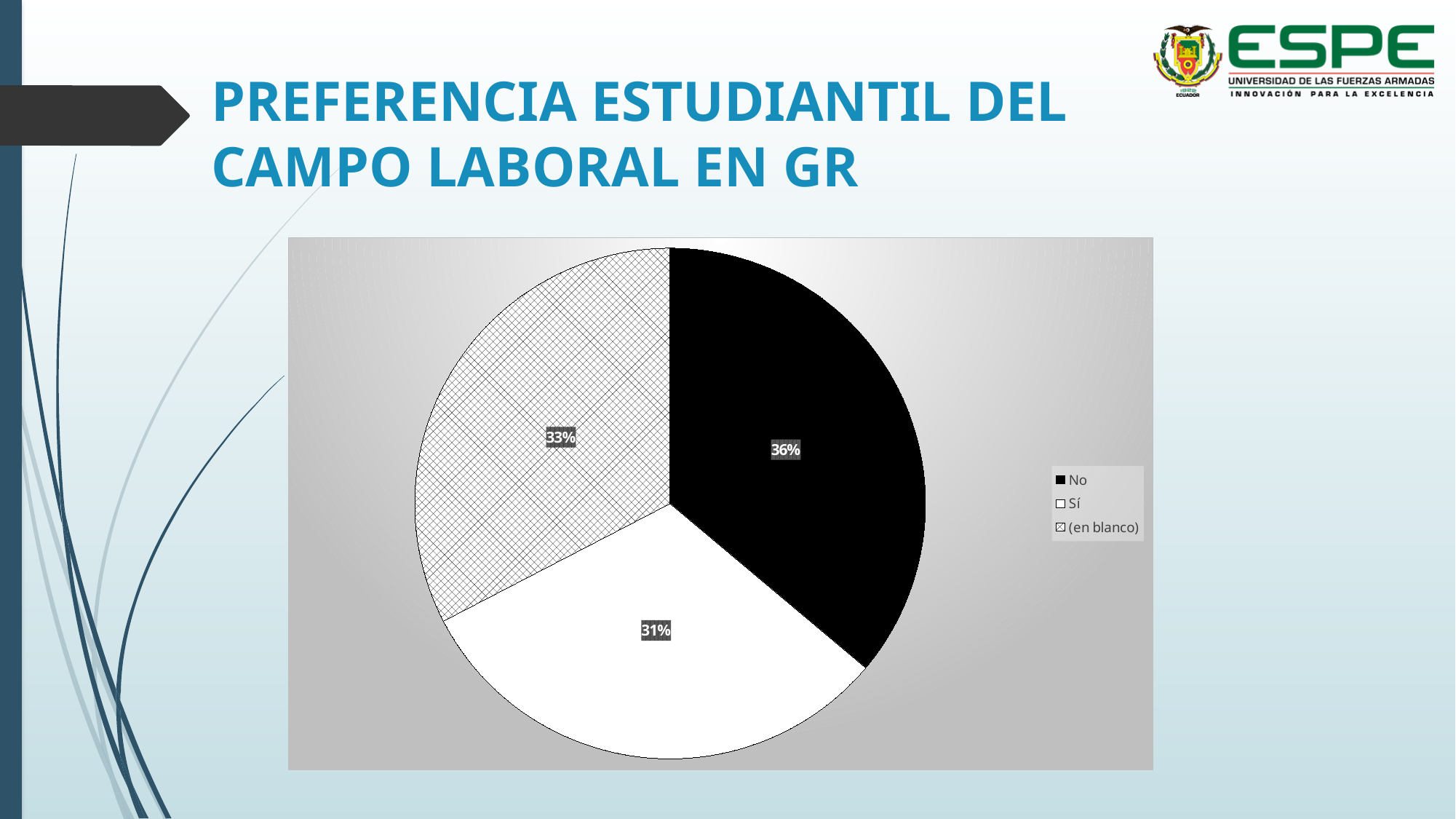
What is the difference in percentage points between the "(en blanco)" slice and the "Sí" slice? 2 What is the difference in percentage points between the "No" slice and the "Sí" slice? 5 How many slices does the pie chart have? 3 What share of the pie does the "(en blanco)" slice represent? 33% What share of the pie does the "Sí" slice represent? 31% Which category has the largest slice of the pie? No What kind of chart is shown on the slide? pie chart How many entries does the legend list? 3 Which category has the smallest slice of the pie? Sí Which is larger, the "No" slice or the "(en blanco)" slice? No What share of the pie does the "No" slice represent? 36% Which category is shown with the solid black slice? No